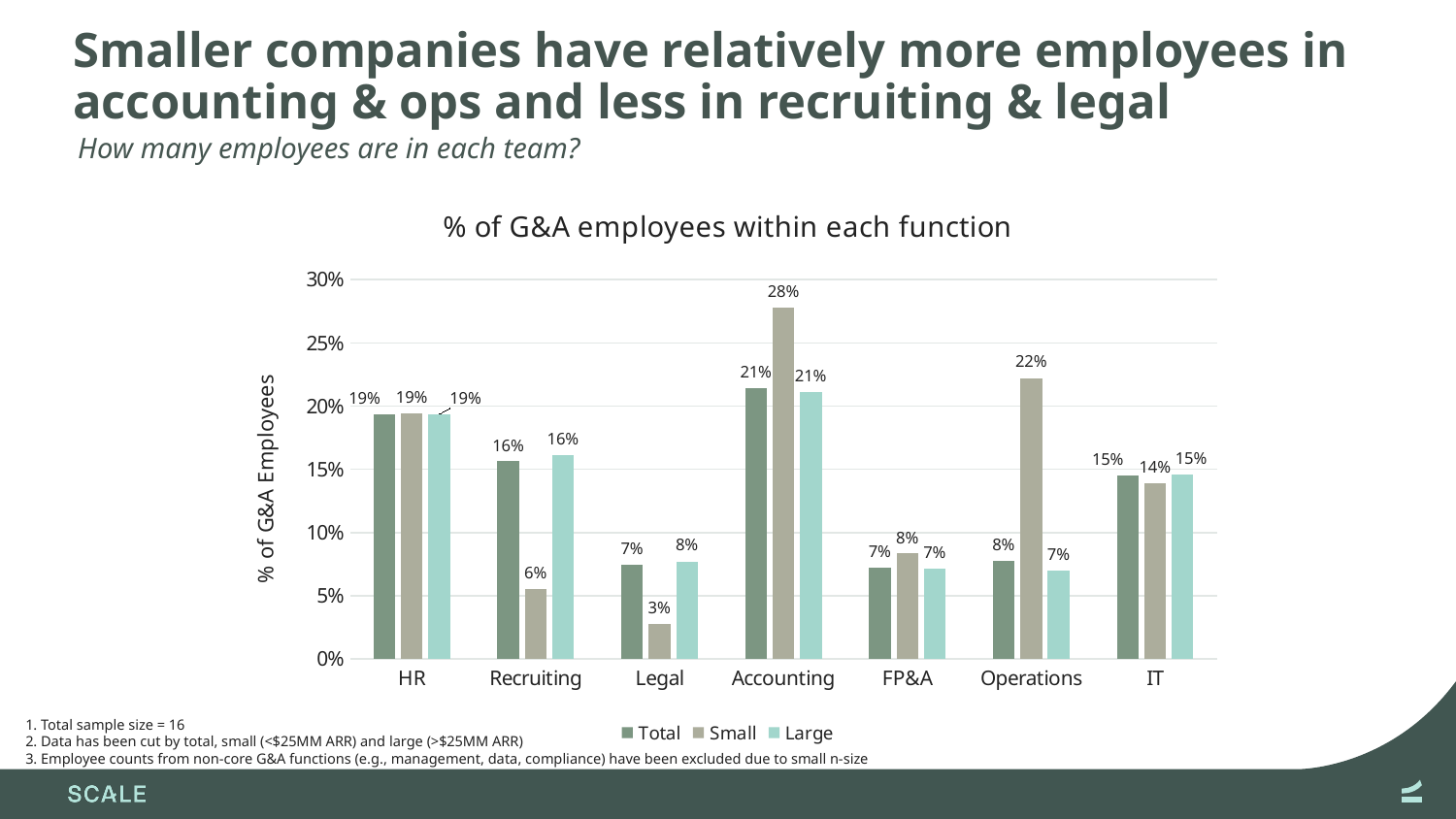
What is the difference between the Small and Large values for Operations? 15% How many series does the legend list? 3 How many functions are shown on the x axis? 7 What is the Small value for Accounting? 28% Which function has the lowest Small value? Legal What is the Total value for IT? 15% What is the title of the chart? % of G&A employees within each function Which is larger for Recruiting, the Small value or the Large value? Large What is the Small value for Legal? 3% What is the Large value for Recruiting? 16% Which function has the highest Small value? Accounting What kind of chart is shown? Bar chart